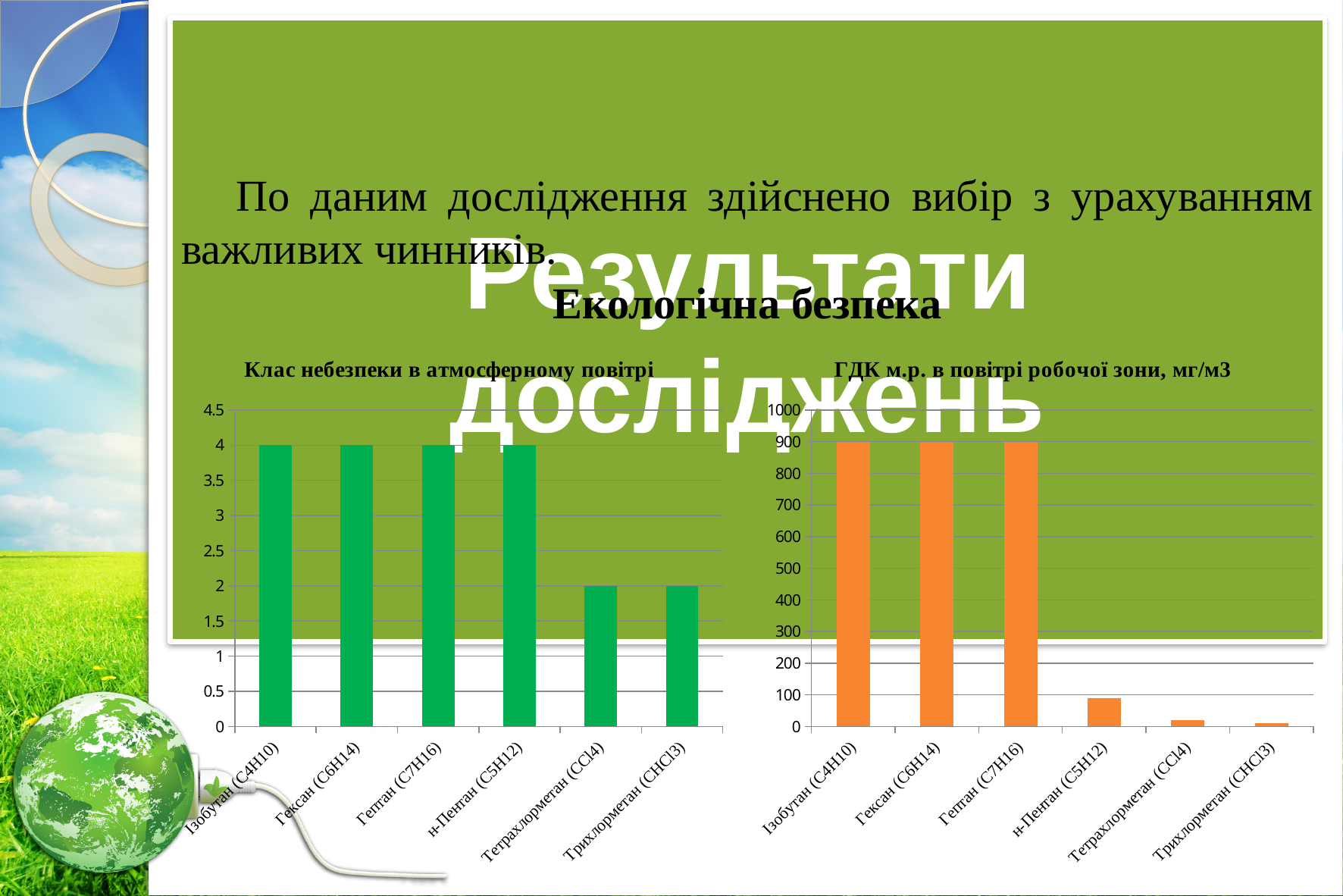
On the chart titled 'Клас небезпеки в атмосферному повітрі', what is the value for Трихлорметан (CHCl3)? 2 On the chart titled 'Клас небезпеки в атмосферному повітрі', how many categories are shown? 6 On the chart titled 'Клас небезпеки в атмосферному повітрі', what is the value for Тетрахлорметан (CCl4)? 2 On the chart titled 'ГДК м.р. в повітрі робочої зони, мг/м3', is the value for Тетрахлорметан (CCl4) greater or less than 100? less On the chart titled 'ГДК м.р. в повітрі робочої зони, мг/м3', what is the value for Гептан (C7H16)? 900 On the chart titled 'ГДК м.р. в повітрі робочої зони, мг/м3', which is larger, the value for н-Пентан (C5H12) or Тетрахлорметан (CCl4)? н-Пентан (C5H12) What colour are the bars on the chart titled 'Клас небезпеки в атмосферному повітрі'? Green On the chart titled 'ГДК м.р. в повітрі робочої зони, мг/м3', do the values rise or fall from left to right along the x axis? Fall On the chart titled 'Клас небезпеки в атмосферному повітрі', what is the difference between the values for Гексан (C6H14) and Тетрахлорметан (CCl4)? 2 What kind of chart is the chart titled 'ГДК м.р. в повітрі робочої зони, мг/м3'? Bar chart On the chart titled 'Клас небезпеки в атмосферному повітрі', what is the value for Ізобутан (C4H10)? 4